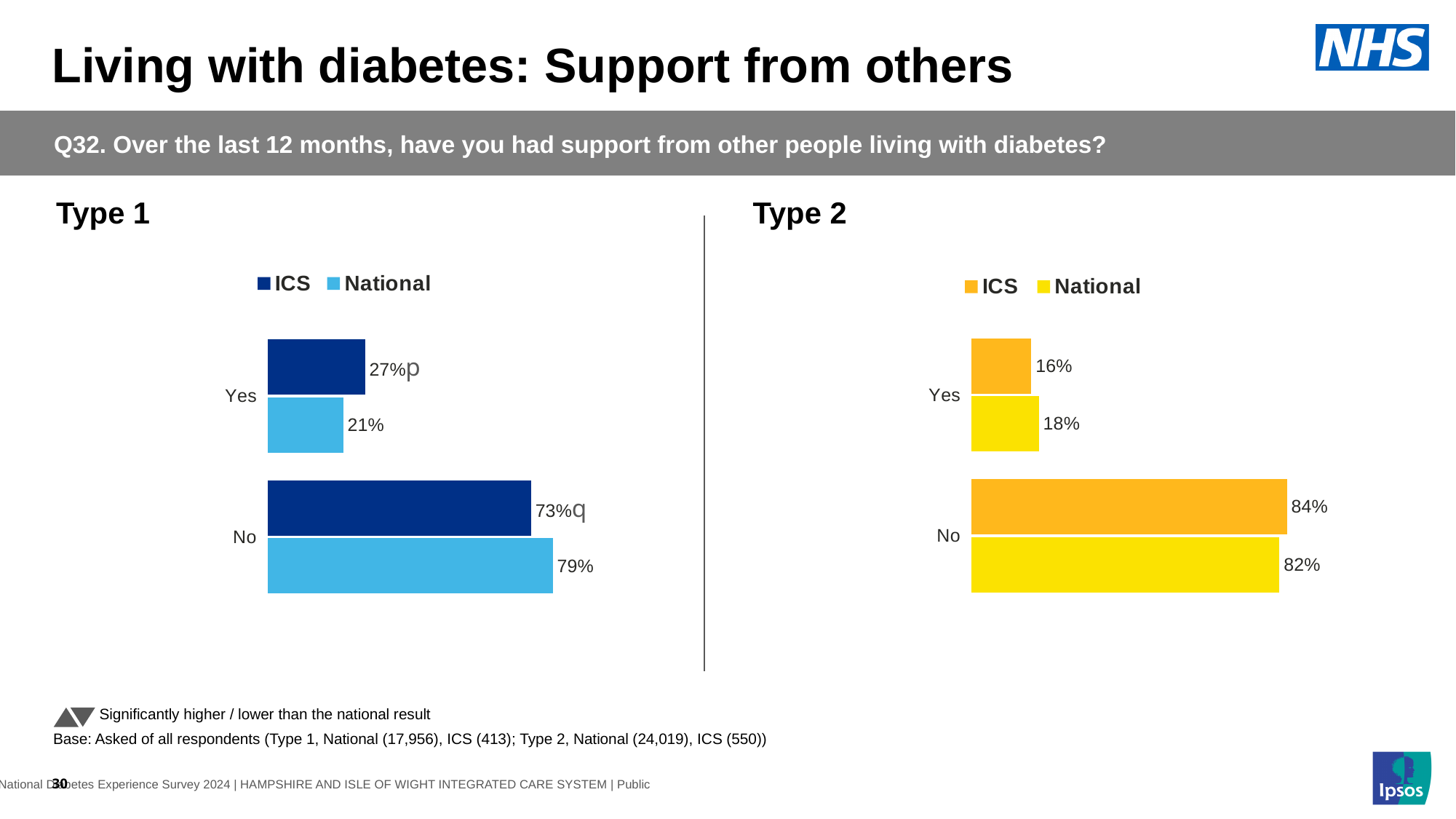
In the Type 2 chart, what is the difference between the National and ICS values for Yes? 2 percentage points What kind of chart is the Type 2 chart? Bar chart In the Type 1 chart, which category has the lowest National value? Yes How many series does the legend of the Type 1 chart list? 2 In the Type 1 chart, which is larger for Yes, the ICS value or the National value? ICS In the Type 1 chart, what is the ICS value for Yes? 27% In the Type 1 chart, what is the difference between the National and ICS values for No? 6 percentage points In the Type 2 chart, what is the National value for Yes? 18% In the Type 1 chart, what is the National value for No? 79% In the Type 2 chart, which is larger for No, the ICS value or the National value? ICS In the Type 2 chart, what is the ICS value for No? 84% In the Type 2 chart, which category has the highest ICS value? No